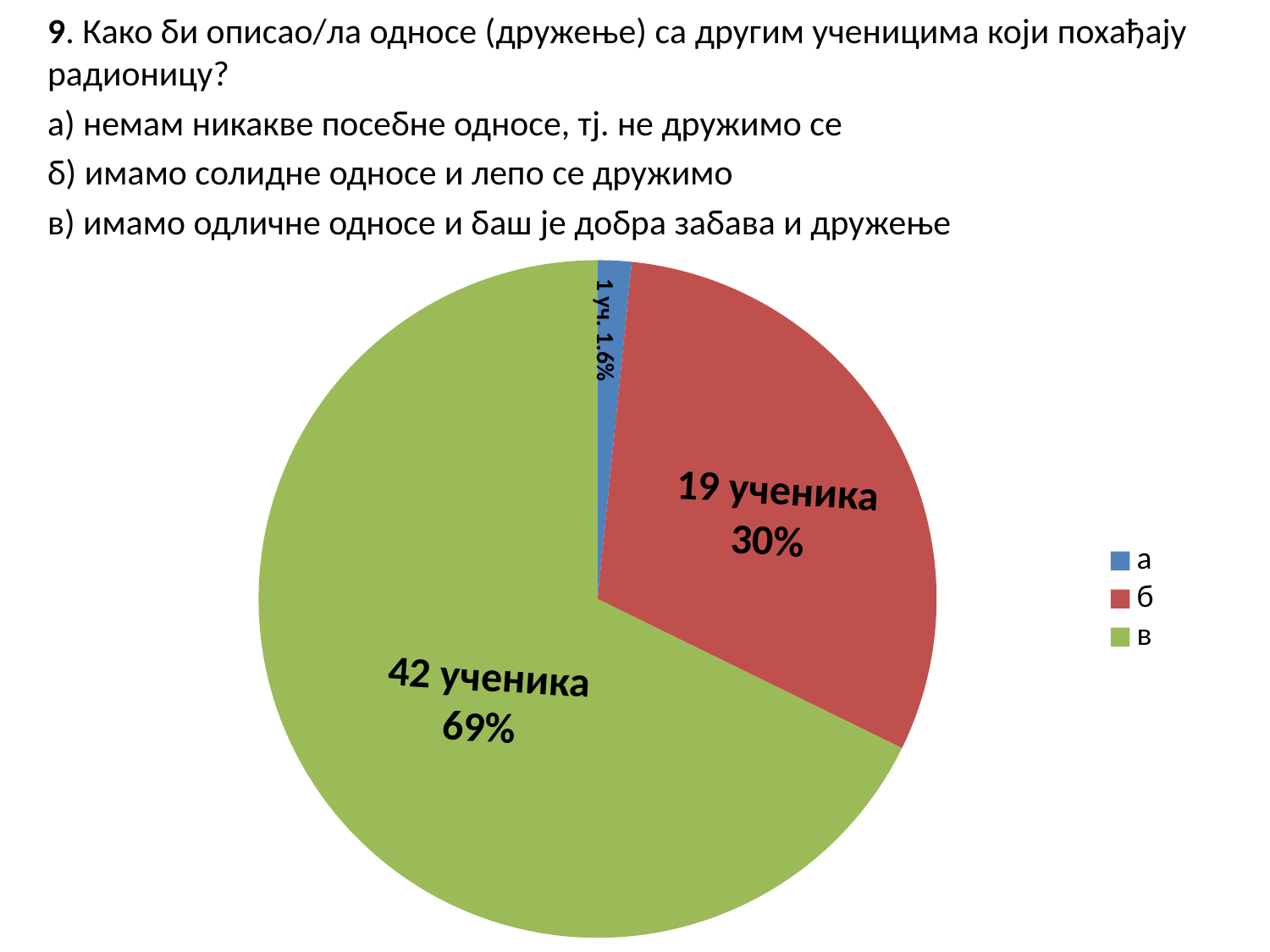
Which slice is the smallest? а What kind of chart is shown on the slide? pie chart How many entries does the legend list? 3 What percentage share does slice б have? 30% How many slices does the pie chart have? 3 How many students are in slice б? 19 ученика What percentage share does slice а have? 1.6% What percentage share does slice в have? 69% How many students are in slice в? 42 ученика Which colour is used for slice в in the pie chart? green Which slice is the largest? в What is the difference in number of students between slice в and slice б? 23